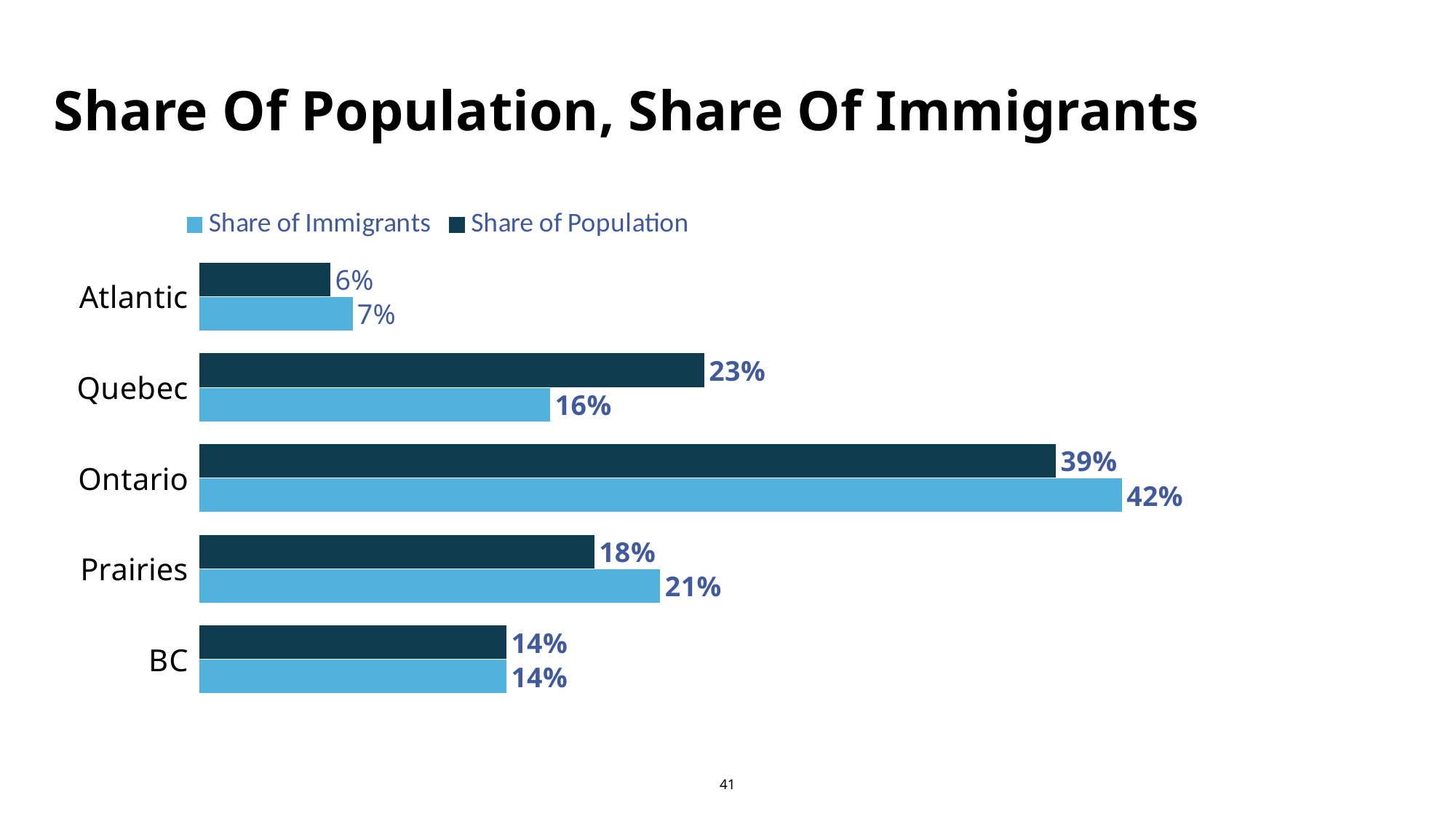
Which region has the highest Share of Immigrants? Ontario Which is larger for the Prairies: Share of Immigrants or Share of Population? Share of Immigrants What is the title of the slide? Share Of Population, Share Of Immigrants What is the Share of Population for the Prairies? 18% What kind of chart is shown on the slide? Bar chart What is the Share of Immigrants for Ontario? 42% What is the difference between Quebec's Share of Population and its Share of Immigrants? 7% How many regions are shown on the chart? 5 What is the Share of Population for Quebec? 23% How many series does the legend list? 2 Which region has the lowest Share of Population? Atlantic What is the Share of Immigrants for Atlantic? 7%